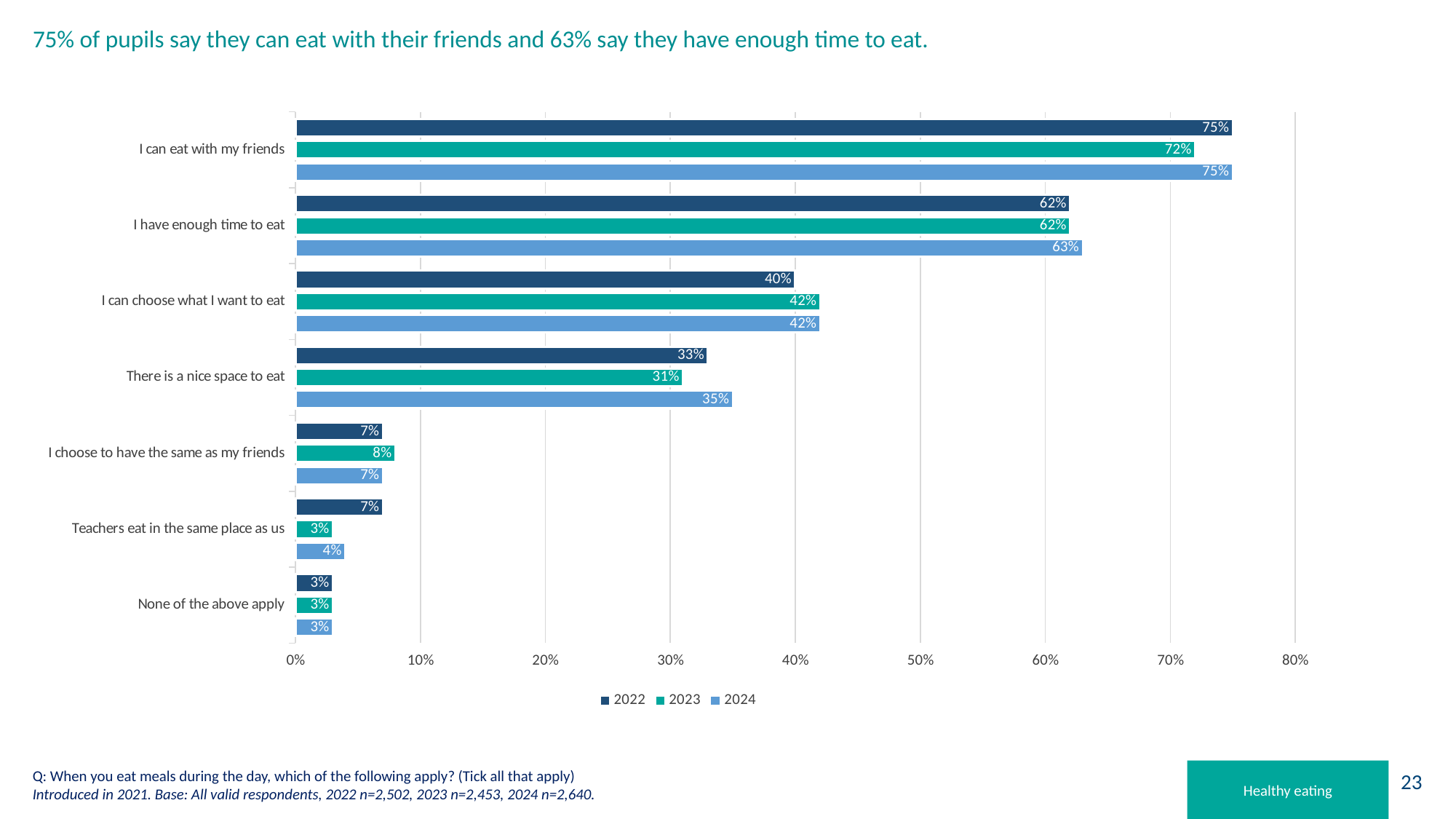
What is the difference between the 2022 and 2023 values for 'Teachers eat in the same place as us'? 4 percentage points Which category has the lowest value in 2023? Teachers eat in the same place as us and None of the above apply (both 3%) What kind of chart is shown on the slide? Bar chart What percentage of pupils said 'I can eat with my friends' in 2024? 75% What is the 2023 value for 'There is a nice space to eat'? 31% What is the difference between the 2024 and 2023 values for 'There is a nice space to eat'? 4 percentage points How many categories are shown on the chart? 7 Which category has the highest value in 2024? I can eat with my friends What is the 2022 value for 'Teachers eat in the same place as us'? 7% Which is larger for 'I can choose what I want to eat': the 2022 value or the 2023 value? 2023 Which years are listed in the chart legend? 2022, 2023, 2024 How many series does the legend list? 3